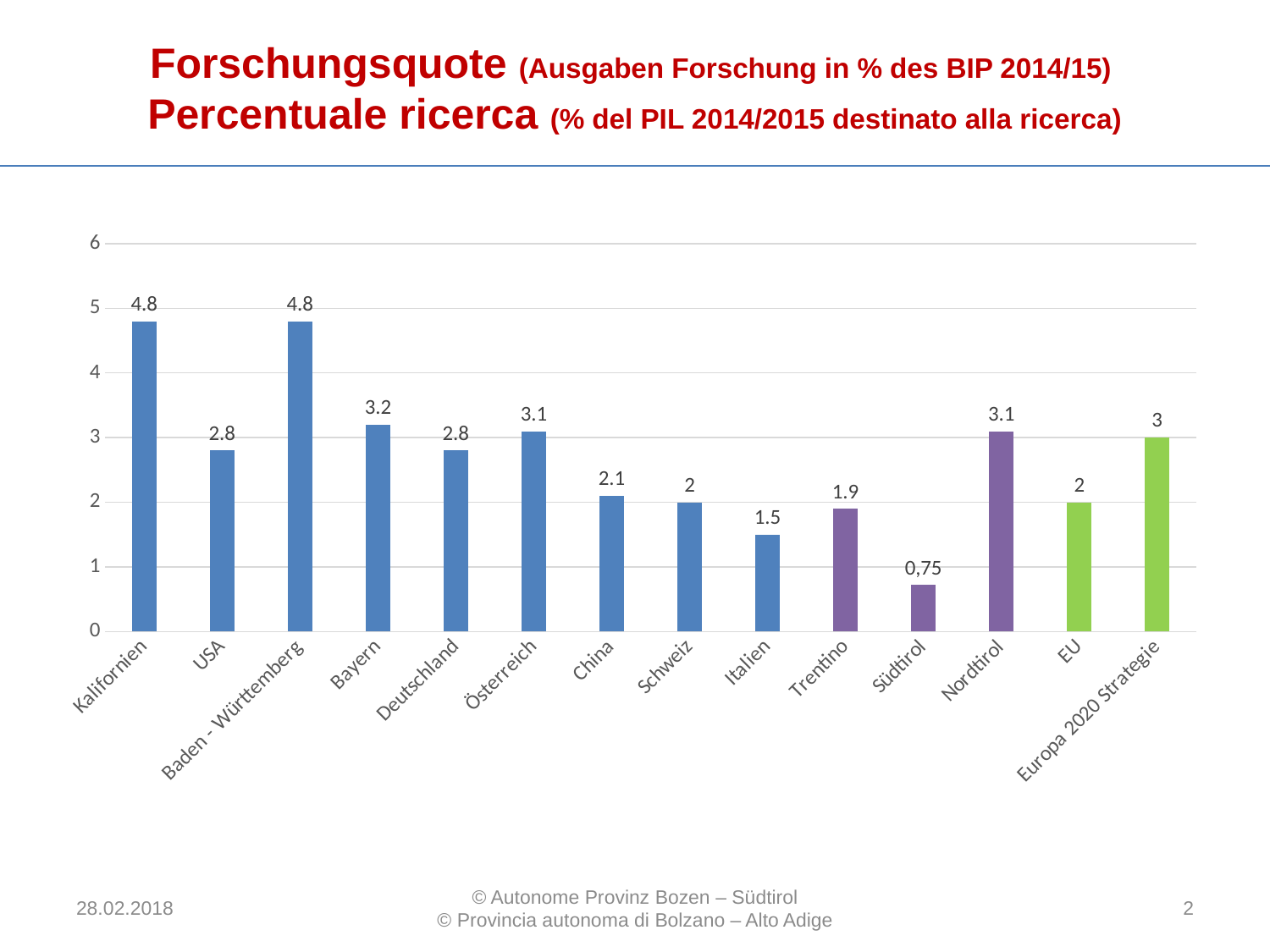
What is the difference between the values for Kalifornien and USA? 2 What is the value for Südtirol? 0,75 What is the difference between the values for Nordtirol and Trentino? 1.2 What is the value for Europa 2020 Strategie? 3 How many categories are shown on the x axis? 14 Which is larger, the value for China or the value for Italien? China Is the value for Schweiz greater or less than 3? less What kind of chart is shown on the slide? Bar chart Which category has the lowest value? Südtirol Which is larger, the value for Österreich or the value for Deutschland? Österreich What is the value for Trentino? 1.9 What is the value for Bayern? 3.2